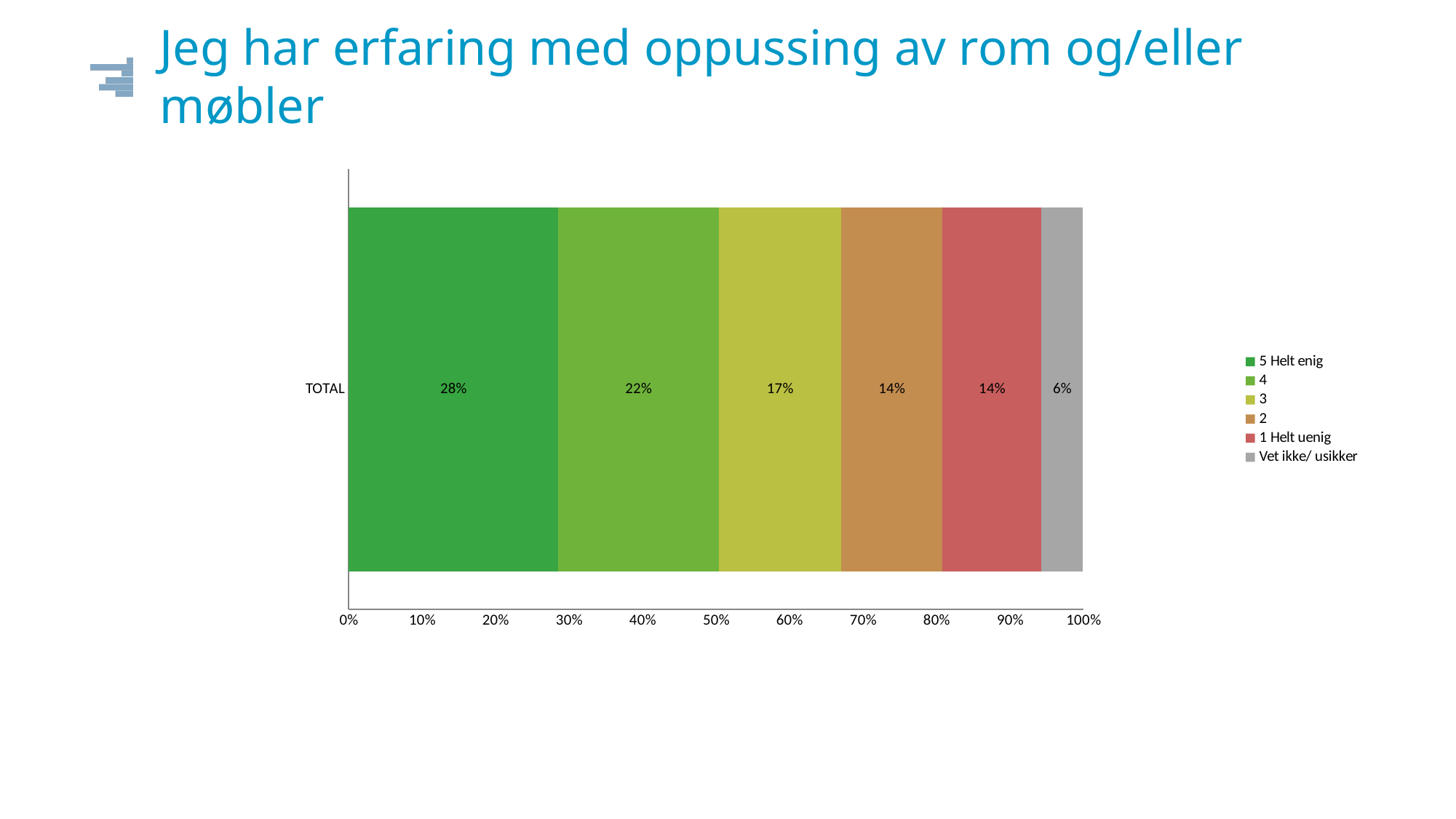
What kind of chart is shown on the slide? Stacked bar chart Which legend category has the smallest segment in the TOTAL bar? Vet ikke/ usikker What is the value for the "4" segment of the TOTAL bar? 22% How many series does the legend list? 6 What percentage of respondents answered "5 Helt enig"? 28% What is the title of the slide? Jeg har erfaring med oppussing av rom og/eller møbler What share of the TOTAL bar is "Vet ikke/ usikker"? 6% What is the difference between the "5 Helt enig" and "4" segments? 6% Which legend category has the largest segment in the TOTAL bar? 5 Helt enig Which is larger, the "3" segment or the "2" segment? 3 What is the value for "1 Helt uenig"? 14%